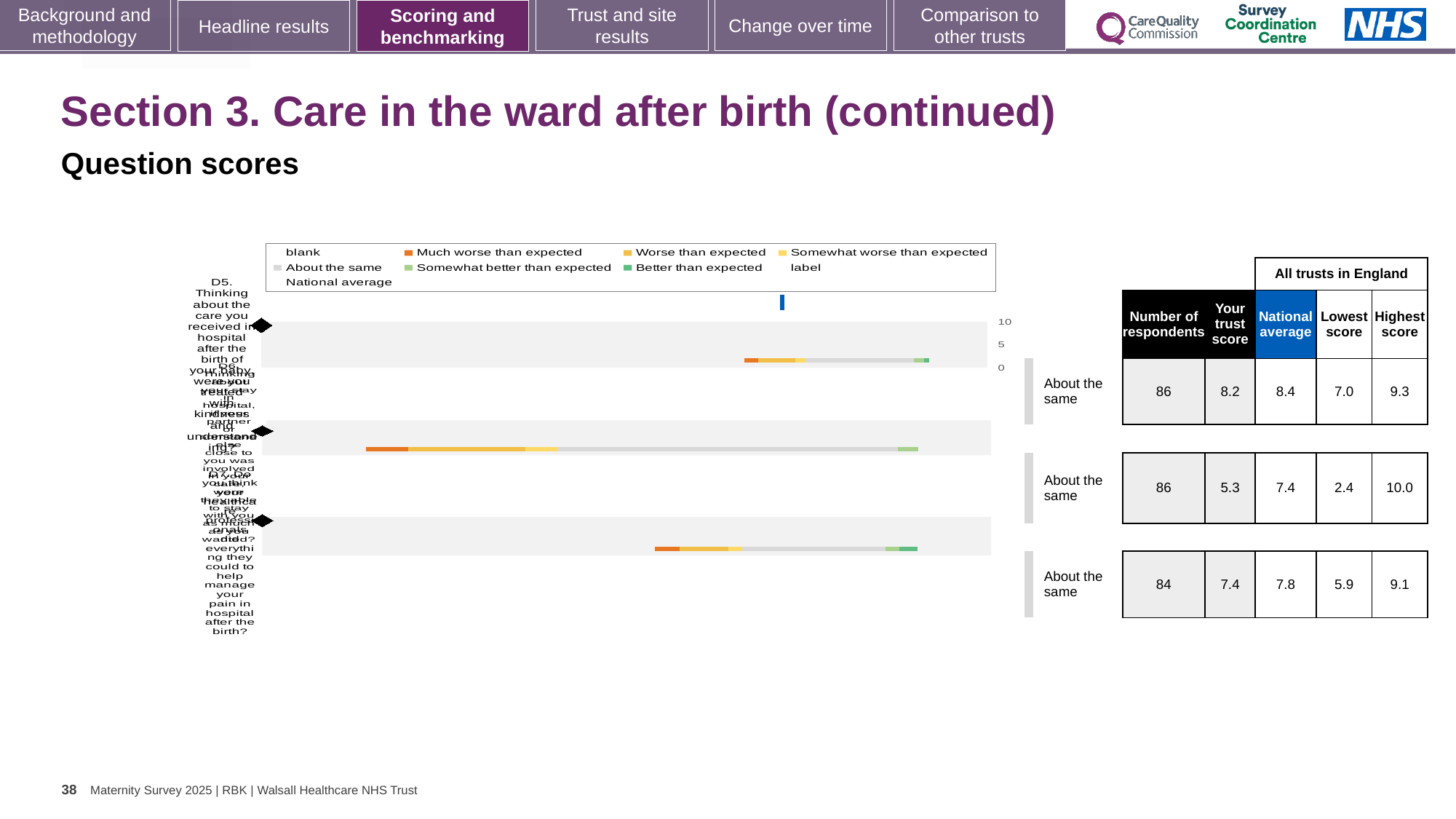
In the table, what is the highest score for the first row? 9.3 What benchmark category is shown next to each of the three bars in the chart? About the same In the table, is the trust score in the first row larger or smaller than the national average in that row? smaller How many question bars are plotted in the chart? 3 In the table, what is the lowest score for the second row? 2.4 In the table, which row has the lowest trust score? the second row (5.3) What kind of chart is shown on the slide? bar chart In the table, what is the trust score for the second row? 5.3 In the table, what is the difference between the national average and the trust score in the second row? 2.1 In the table, what is the national average for the third row? 7.8 In the table, what is the number of respondents for the first row? 86 What is the highest value shown on the chart's axis? 10